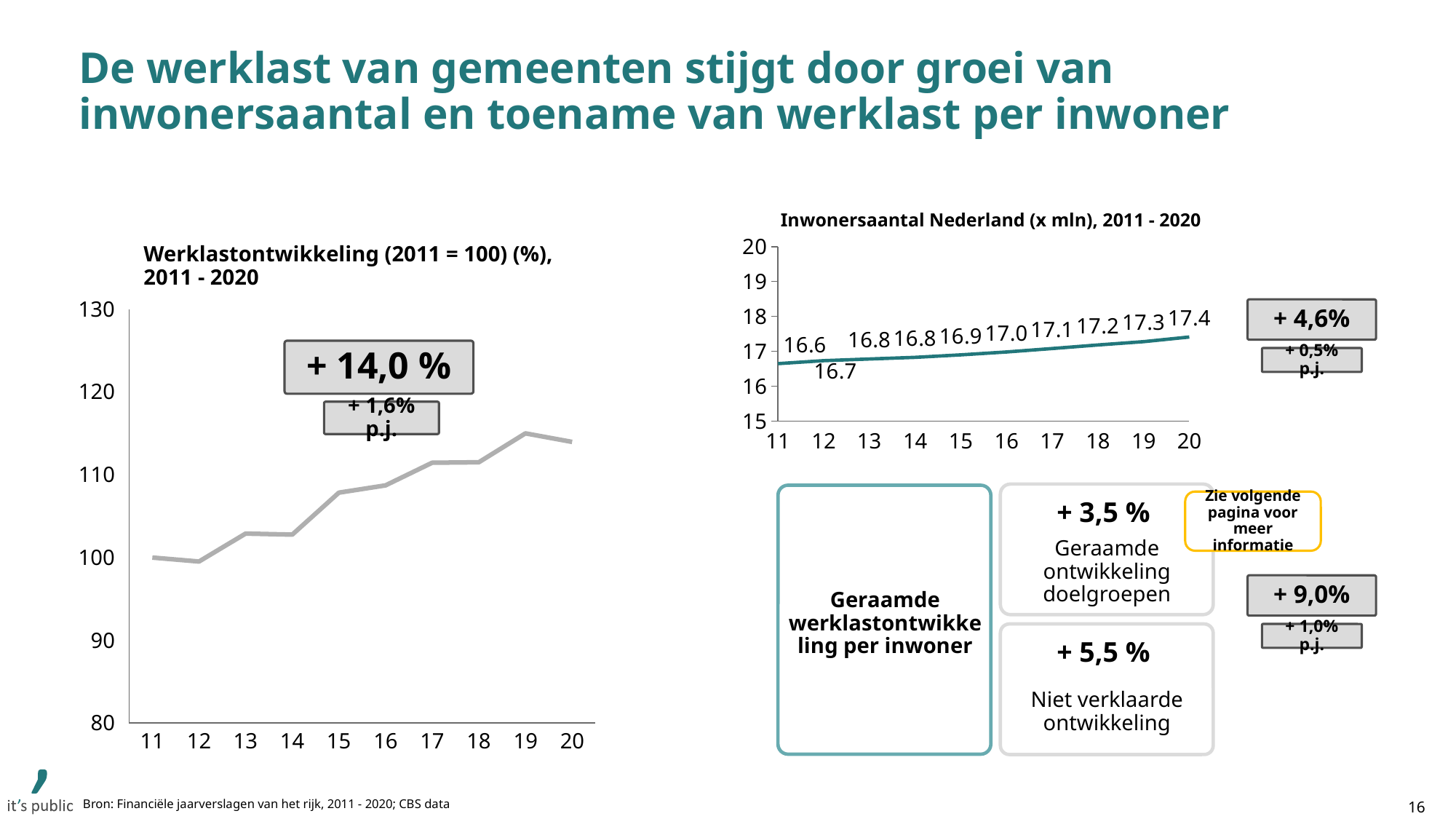
In the 'Werklastontwikkeling (2011 = 100) (%), 2011 - 2020' chart, which is larger, the value for 15 or the value for 12? 15 In the 'Inwonersaantal Nederland (x mln), 2011 - 2020' chart, what is the difference between the values for 20 and 11? 0.8 In the 'Inwonersaantal Nederland (x mln), 2011 - 2020' chart, what is the value for 11? 16.6 In the 'Inwonersaantal Nederland (x mln), 2011 - 2020' chart, which year has the highest value? 20 In the 'Inwonersaantal Nederland (x mln), 2011 - 2020' chart, what is the value for 16? 17.0 In the 'Inwonersaantal Nederland (x mln), 2011 - 2020' chart, which year has the lowest value? 11 In the 'Inwonersaantal Nederland (x mln), 2011 - 2020' chart, do the values rise or fall from 11 to 20? rise In the 'Inwonersaantal Nederland (x mln), 2011 - 2020' chart, what is the value for 20? 17.4 In the 'Werklastontwikkeling (2011 = 100) (%), 2011 - 2020' chart, is the value for 13 greater or less than 110? less What type of chart is the 'Inwonersaantal Nederland (x mln), 2011 - 2020' chart? line chart In the 'Werklastontwikkeling (2011 = 100) (%), 2011 - 2020' chart, is the value for 19 greater or less than 110? greater In the 'Inwonersaantal Nederland (x mln), 2011 - 2020' chart, how many data points are plotted? 10